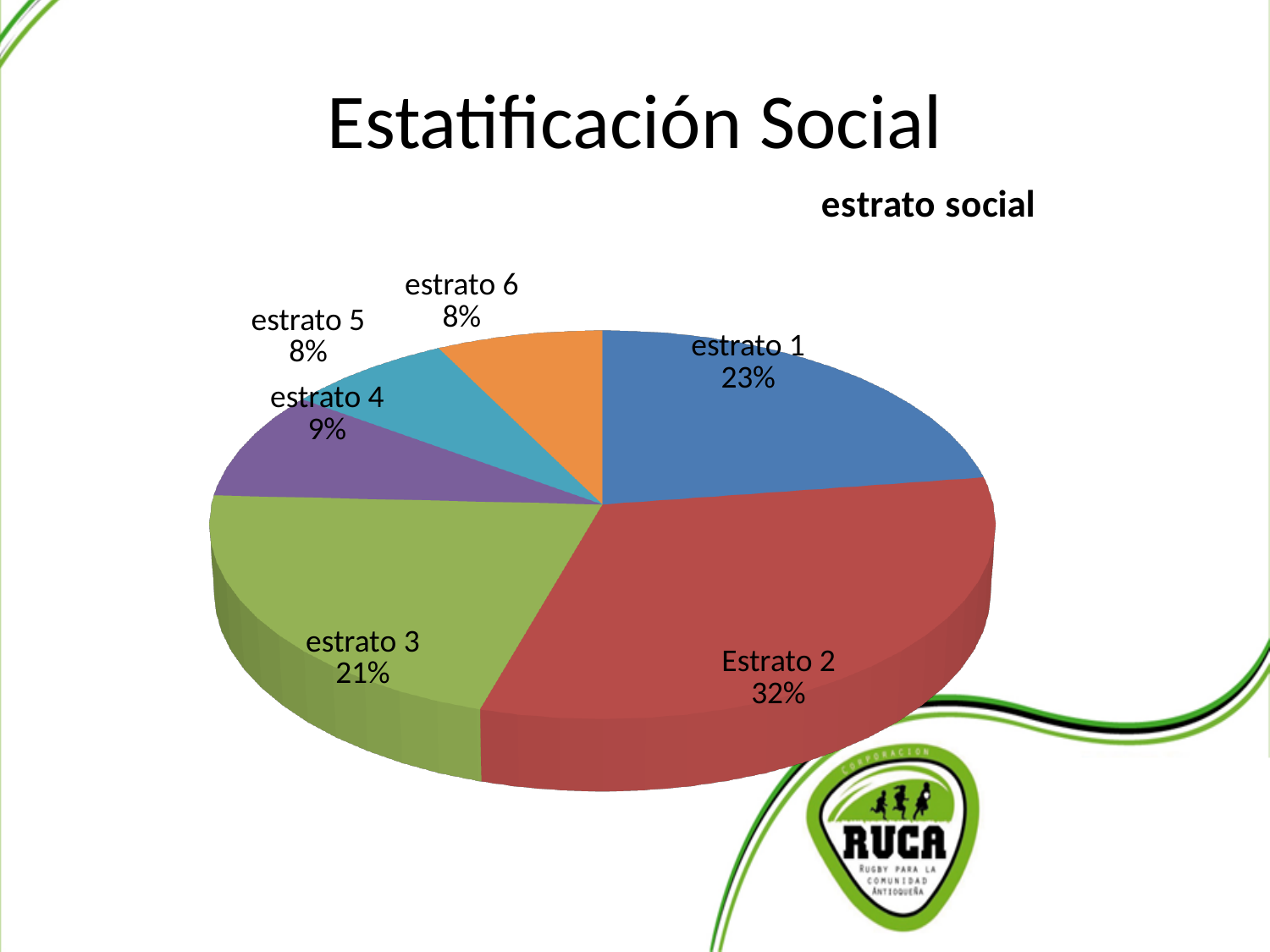
What percentage share does estrato 1 have? 23% Which is larger, the share for estrato 1 or the share for estrato 3? estrato 1 Which category has the largest share of the pie? Estrato 2 What type of chart is shown on the slide? pie chart What is the difference in percentage points between Estrato 2 and estrato 3? 11 What percentage share does estrato 3 have? 21% What percentage share does Estrato 2 have? 32% What is the combined share of estrato 5 and estrato 6? 16% What percentage share does estrato 4 have? 9% What is the title of the chart? estrato social How many slices does the pie chart have? 6 What colour is the slice for Estrato 2? red